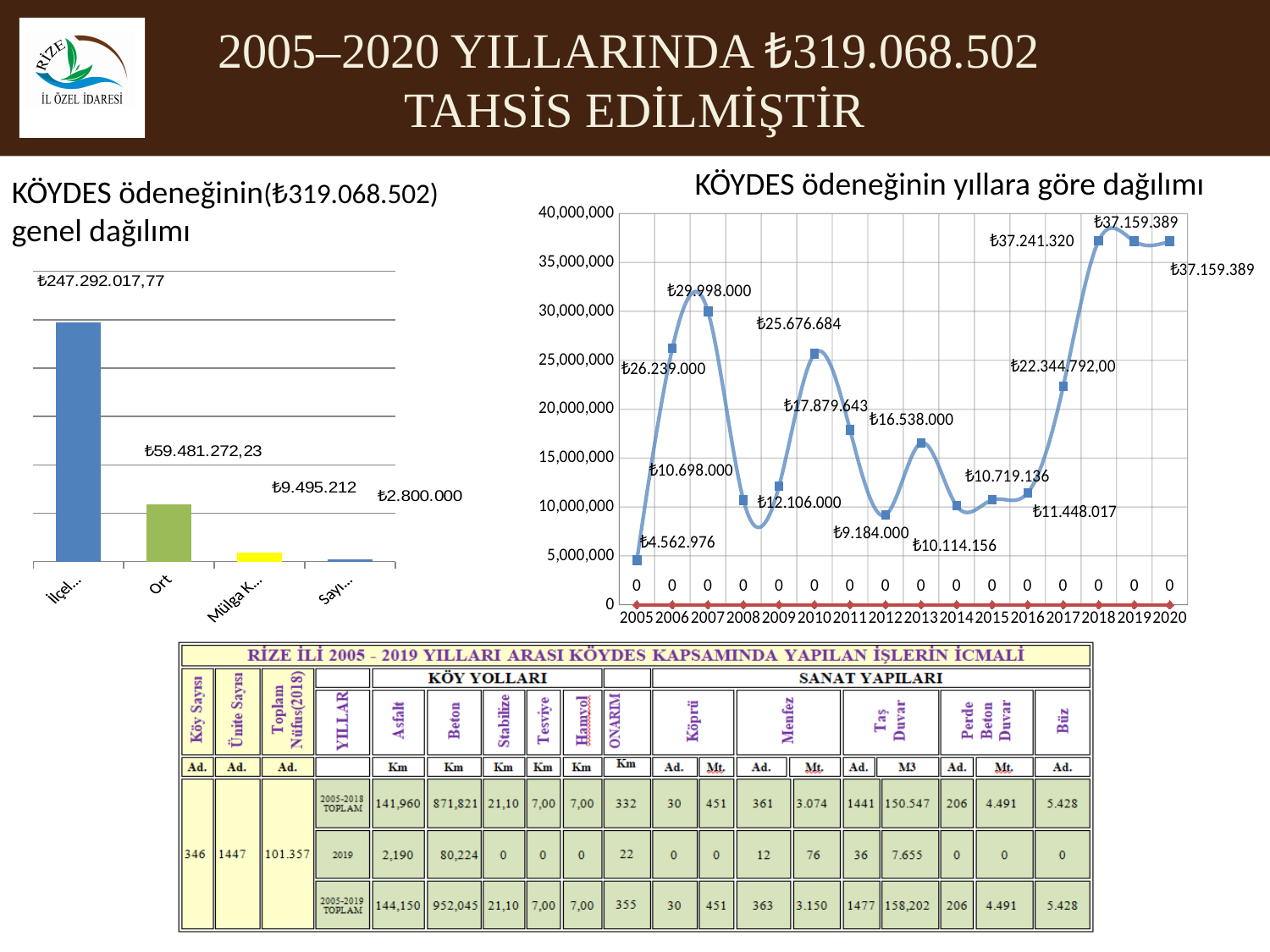
In the right chart 'KÖYDES ödeneğinin yıllara göre dağılımı', how many years are shown on the x axis? 16 In the left chart 'KÖYDES ödeneğinin genel dağılımı', how many bars are shown? 4 In the left chart 'KÖYDES ödeneğinin genel dağılımı', what is the value of the last (smallest) bar? ₺2.800.000 In the left chart 'KÖYDES ödeneğinin genel dağılımı', what is the value for 'Ort'? ₺59.481.272,23 In the right chart 'KÖYDES ödeneğinin yıllara göre dağılımı', what is the value for 2005? ₺4.562.976 In the right chart 'KÖYDES ödeneğinin yıllara göre dağılımı', which year has the lowest value on the blue line? 2005 In the right chart 'KÖYDES ödeneğinin yıllara göre dağılımı', which is larger: the value for 2007 or the value for 2008? 2007 What kind of chart is the left chart 'KÖYDES ödeneğinin genel dağılımı'? Bar chart In the right chart 'KÖYDES ödeneğinin yıllara göre dağılımı', what is the value for 2018? ₺37.241.320 In the left chart 'KÖYDES ödeneğinin genel dağılımı', what is the value of the first (tallest) bar? ₺247.292.017,77 In the right chart 'KÖYDES ödeneğinin yıllara göre dağılımı', what is the value for 2010? ₺25.676.684 In the right chart 'KÖYDES ödeneğinin yıllara göre dağılımı', is the value for 2017 greater or less than 20,000,000? greater